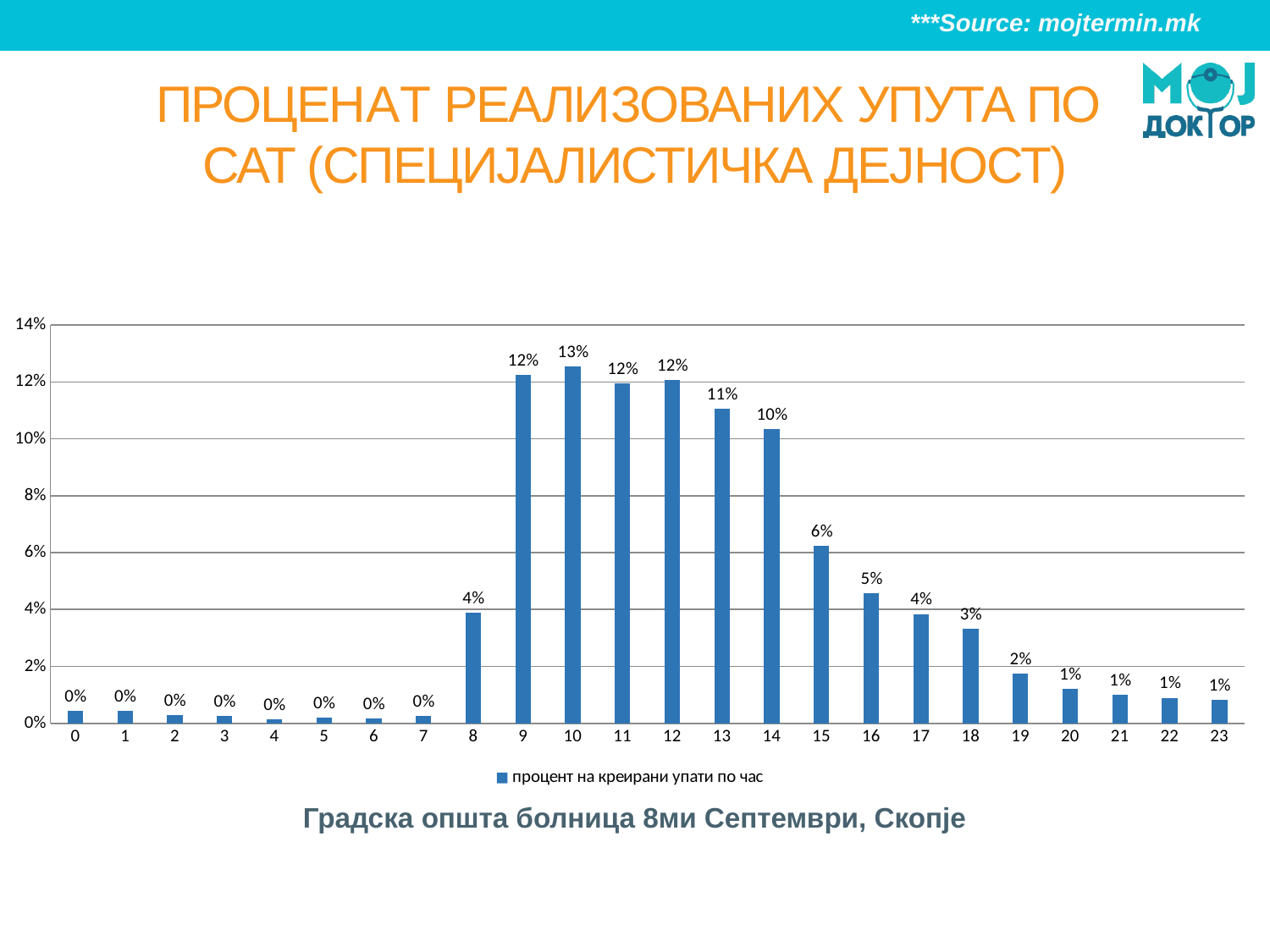
What is the value for hour 10? 13% Do the values rise or fall from hour 10 to hour 18? fall Is the value for hour 13 greater or less than 10%? greater What kind of chart is shown on the slide? bar chart Which is larger, the value for hour 9 or the value for hour 15? hour 9 What is the value for hour 15? 6% What is the value for hour 8? 4% What is the difference between the value for hour 10 and the value for hour 8? 9% What is the value for hour 18? 3% Which hour has the highest value? 10 How many series does the legend list? 1 How many hours (categories) are shown on the x axis? 24